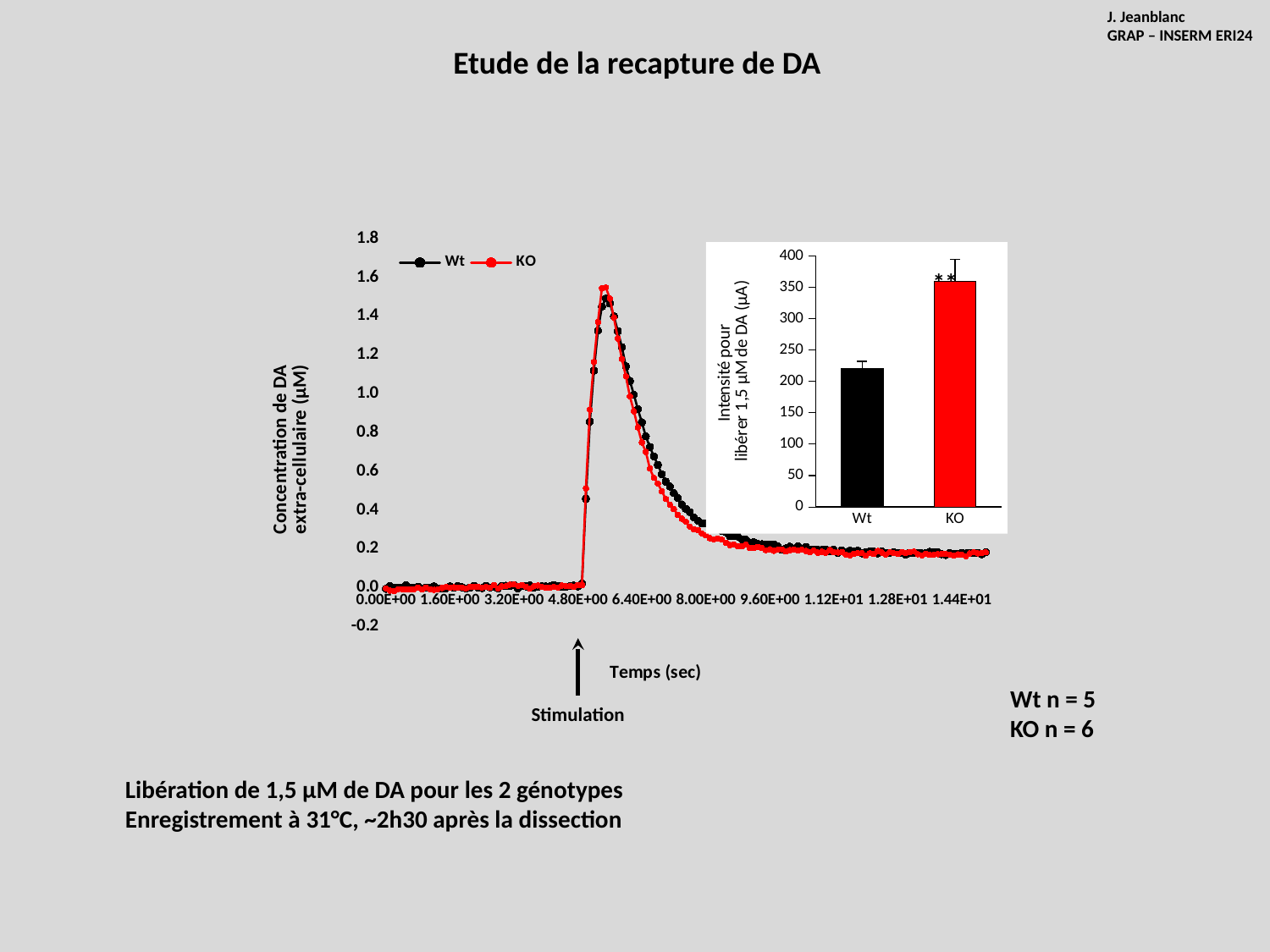
In the inset bar chart, is the value for KO greater or less than 400? less How many categories are shown in the inset bar chart? 2 How many series does the legend of the large line chart list? 2 What kind of chart is the inset chart on the right? bar chart In the large line chart, do the values rise or fall along the x axis after the peak at around 5.5 seconds? fall What is the y-axis label of the inset bar chart? Intensité pour libérer 1,5 µM de DA (µA) In the inset bar chart, is the value for Wt greater or less than 250? less In the inset bar chart, is the value for KO greater or less than 300? greater In the inset bar chart, which category has the higher bar, Wt or KO? KO In the inset bar chart, which category has the lowest value? Wt What kind of chart is the large chart on the left showing concentration over time? line chart